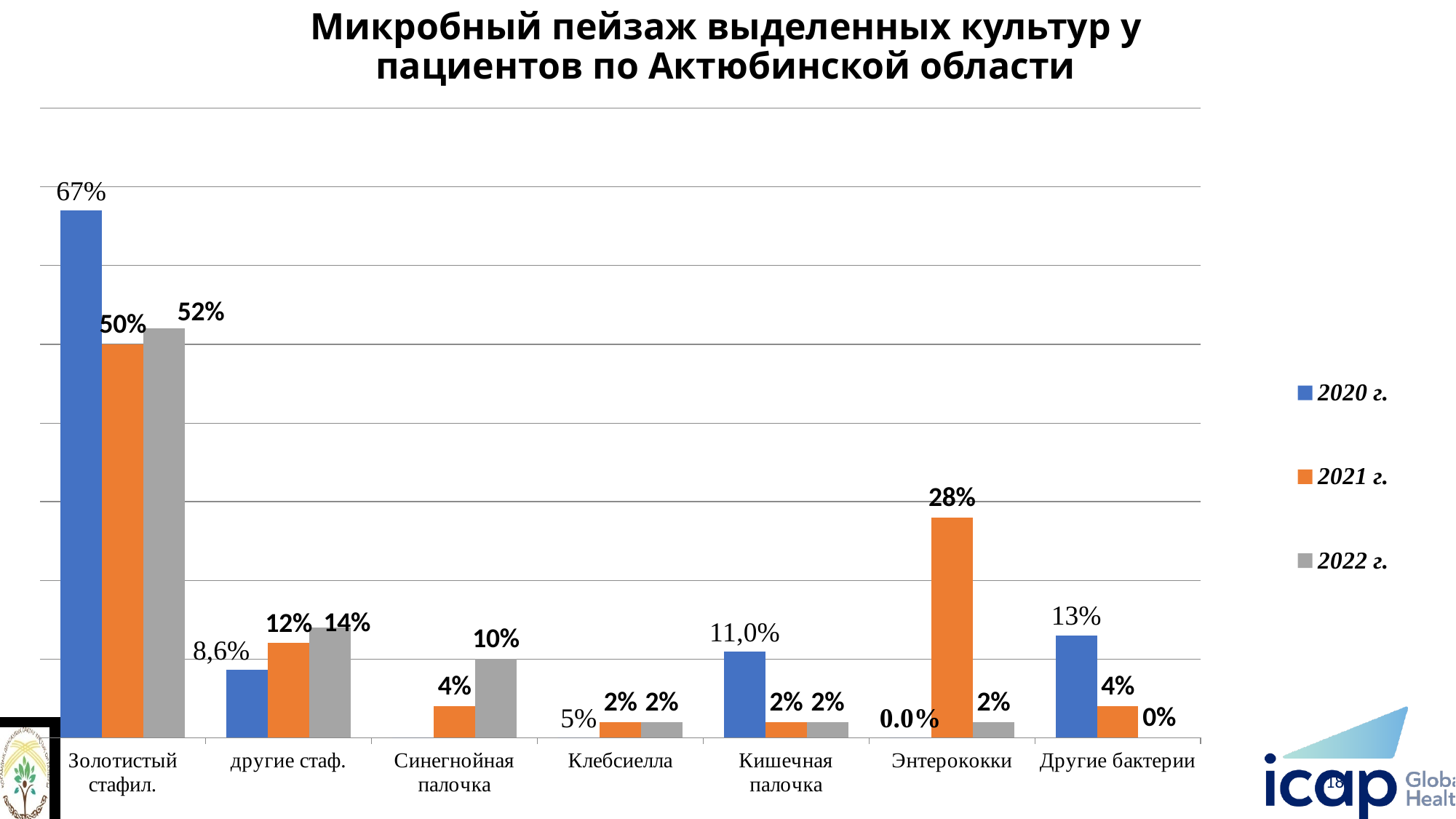
What is the value for Синегнойная палочка in the 2022 г. series? 10% Which is larger for Кишечная палочка: the 2020 г. value or the 2021 г. value? 2020 г. What is the value for Энтерококки in the 2021 г. series? 28% What is the value for Золотистый стафил. in the 2020 г. series? 67% What kind of chart is shown on the slide? Bar chart Which category has the highest value in the 2021 г. series? Золотистый стафил. What is the value for Другие бактерии in the 2022 г. series? 0% How many categories are shown on the x axis? 7 How many series does the legend list? 3 What is the difference between the 2020 г. and 2021 г. values for Золотистый стафил.? 17% What is the value for другие стаф. in the 2020 г. series? 8,6%